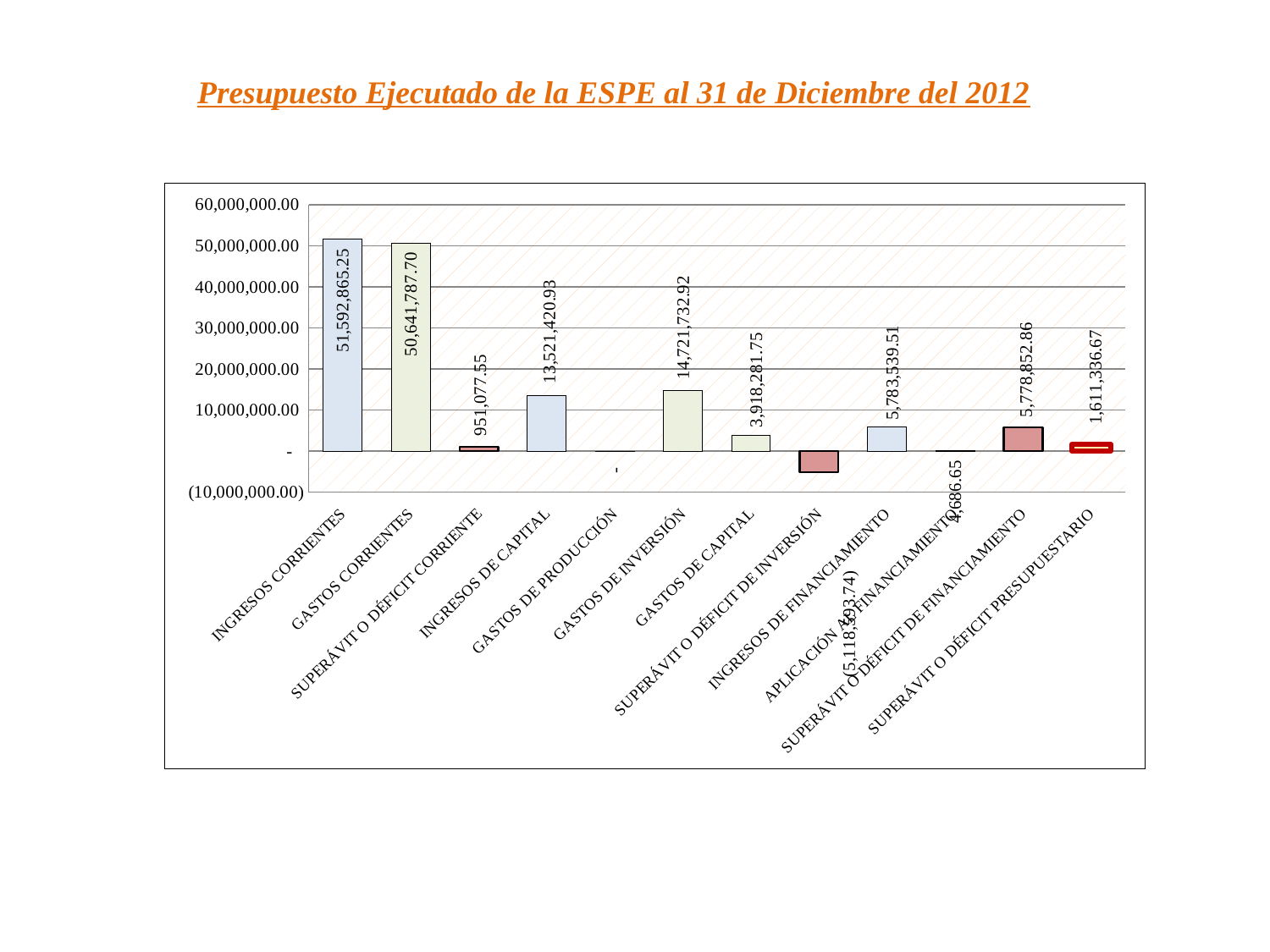
Which is larger, INGRESOS DE CAPITAL or GASTOS DE CAPITAL? INGRESOS DE CAPITAL What is the value for GASTOS DE INVERSIÓN? 14,721,732.92 How many categories are shown on the x axis? 12 Which category has the lowest value? SUPERÁVIT O DÉFICIT DE INVERSIÓN What is the value for INGRESOS CORRIENTES? 51,592,865.25 What kind of chart is shown on the slide? bar chart What is the value for GASTOS CORRIENTES? 50,641,787.70 What is the value for INGRESOS DE FINANCIAMIENTO? 5,783,539.51 What is the value for SUPERÁVIT O DÉFICIT PRESUPUESTARIO? 1,611,336.67 Which category has the highest value? INGRESOS CORRIENTES Is the value for INGRESOS DE CAPITAL greater or less than 10,000,000.00? greater What is the difference between INGRESOS CORRIENTES and GASTOS CORRIENTES? 951,077.55